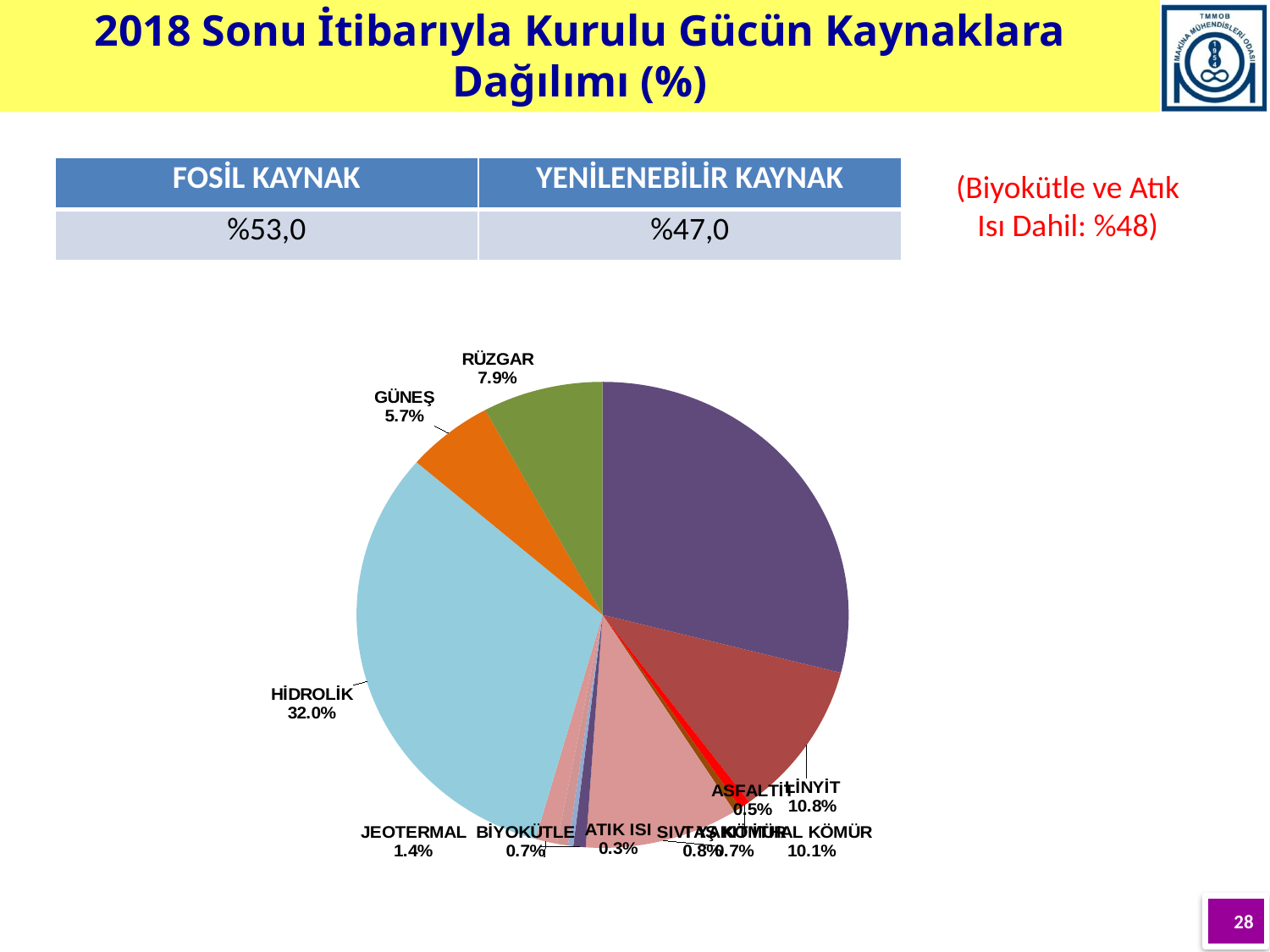
What is the difference between the RÜZGAR and GÜNEŞ shares? 2.2% What is the value shown for İTHAL KÖMÜR? 10.1% What is the value shown for JEOTERMAL? 1.4% What is the difference between the LİNYİT and İTHAL KÖMÜR shares? 0.7% What is the value shown for GÜNEŞ? 5.7% Which is larger, the share for HİDROLİK or the share for RÜZGAR? HİDROLİK What is the title of the slide containing the chart? 2018 Sonu İtibarıyla Kurulu Gücün Kaynaklara Dağılımı (%) What is the value shown for LİNYİT? 10.8% Which is larger, the share for LİNYİT or the share for İTHAL KÖMÜR? LİNYİT What is the value shown for RÜZGAR? 7.9% What kind of chart is shown on the slide? Pie chart What share of the pie does HİDROLİK represent? 32.0%